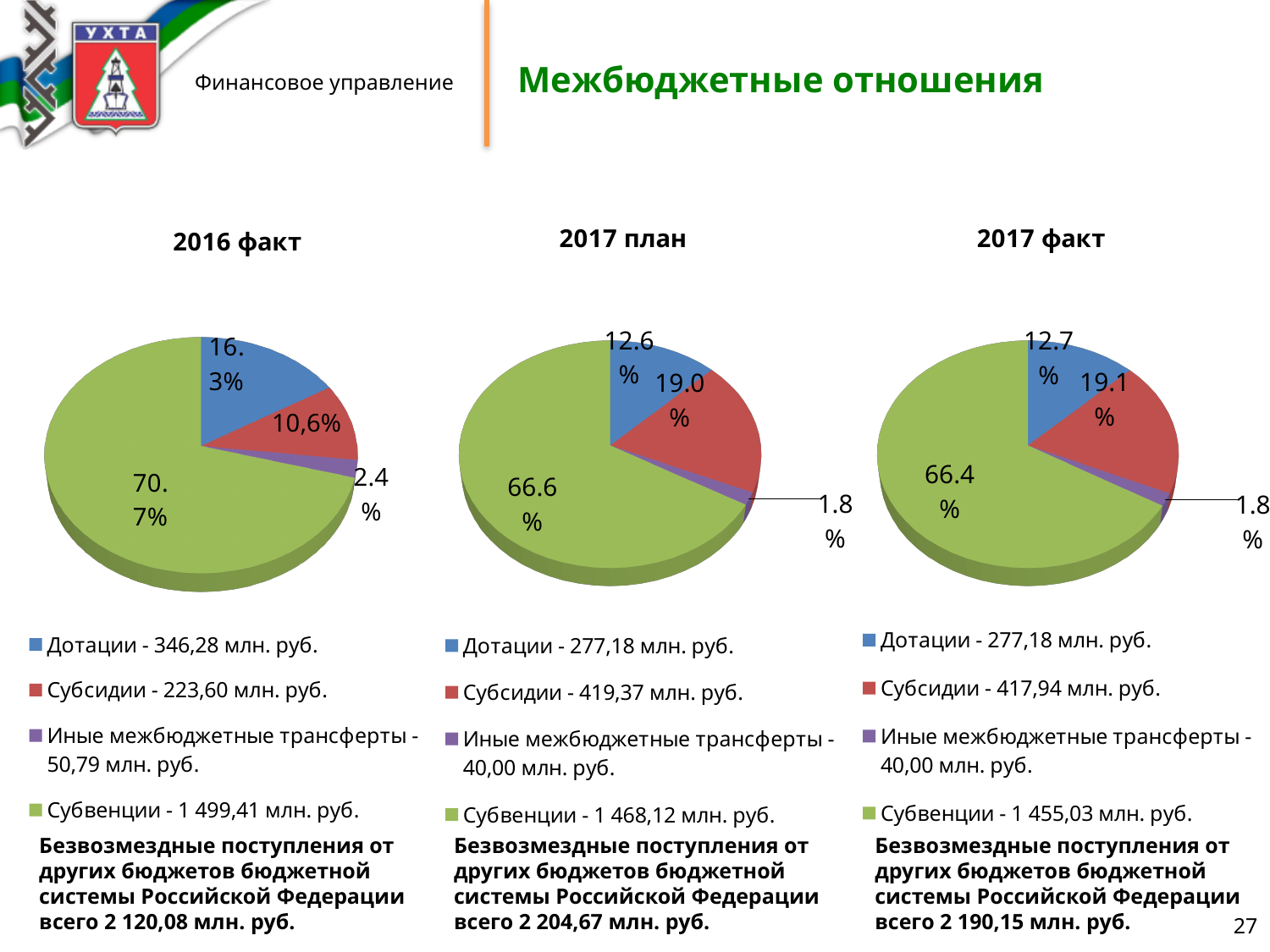
In the 2016 факт pie chart, which category has the smallest slice? Иные межбюджетные трансферты In the 2017 план pie chart, what share is labelled for the Дотации slice? 12.6% In the 2017 план pie chart, which slice is larger: Дотации or Субсидии? Субсидии In the 2016 факт pie chart, what share is labelled for the Субсидии slice? 10,6% How many entries does the legend of the 2016 факт pie chart list? 4 How many slices does the 2017 факт pie chart have? 4 In the 2017 факт pie chart, what share is labelled for the Субсидии slice? 19.1% In the 2017 факт pie chart, what is the difference between the Субвенции share and the Субсидии share? 47.3% What kind of chart is used for the 2016 факт data? pie chart In the 2017 факт pie chart, which category has the largest slice? Субвенции